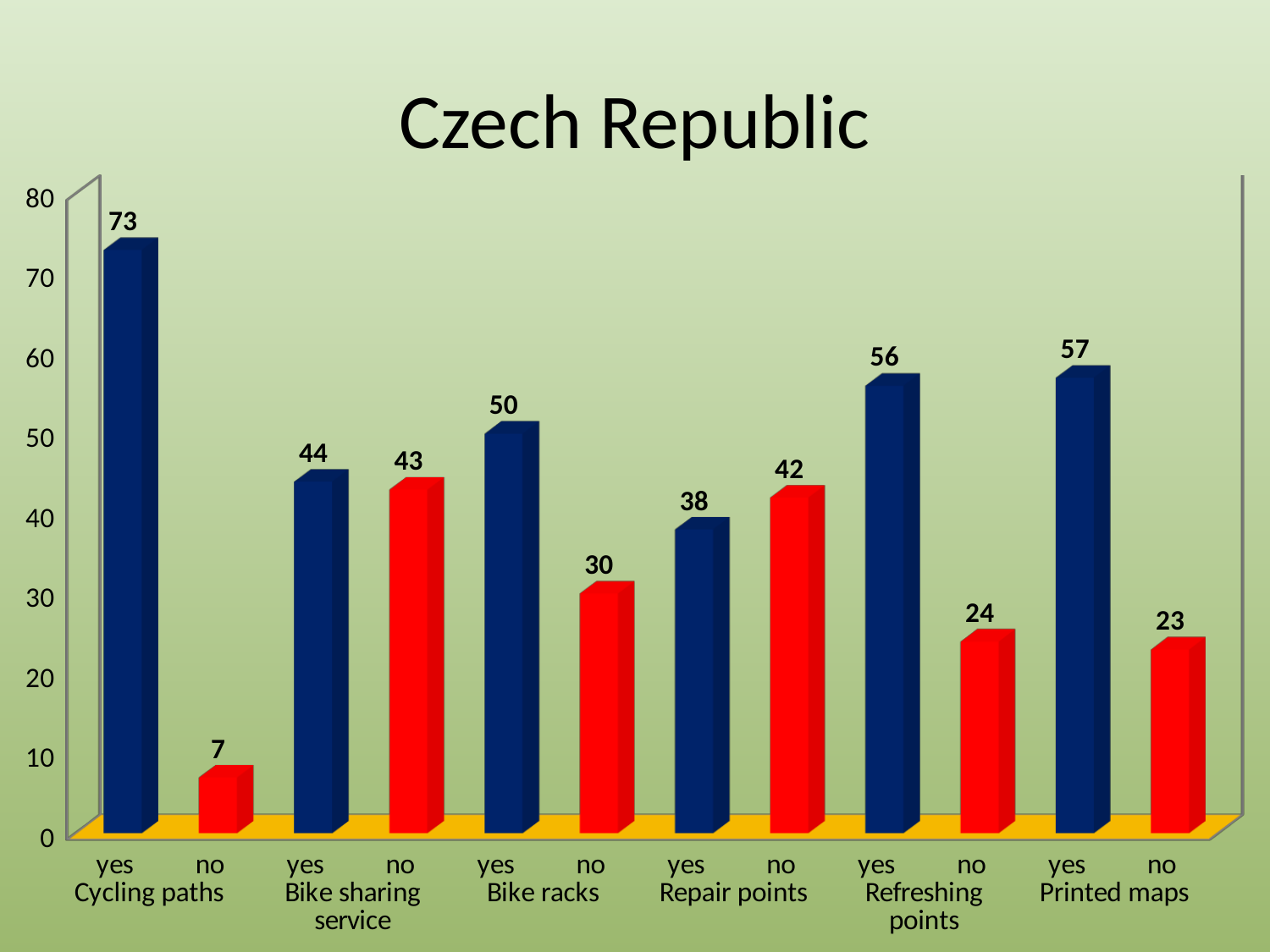
Which is larger for Repair points, the 'yes' value or the 'no' value? no What is the value for 'no' under Repair points? 42 What is the title of the chart? Czech Republic What is the value for 'no' under Printed maps? 23 Which bar has the lowest value on the chart? no, Cycling paths Is the value for 'yes' under Refreshing points greater or less than 50? greater What is the difference between the 'yes' and 'no' values for Bike racks? 20 What is the value for 'yes' under Cycling paths? 73 Which bar has the highest value on the chart? yes, Cycling paths What colour are the 'no' bars? red How many bars are plotted on the chart? 12 What kind of chart is shown on the slide? bar chart